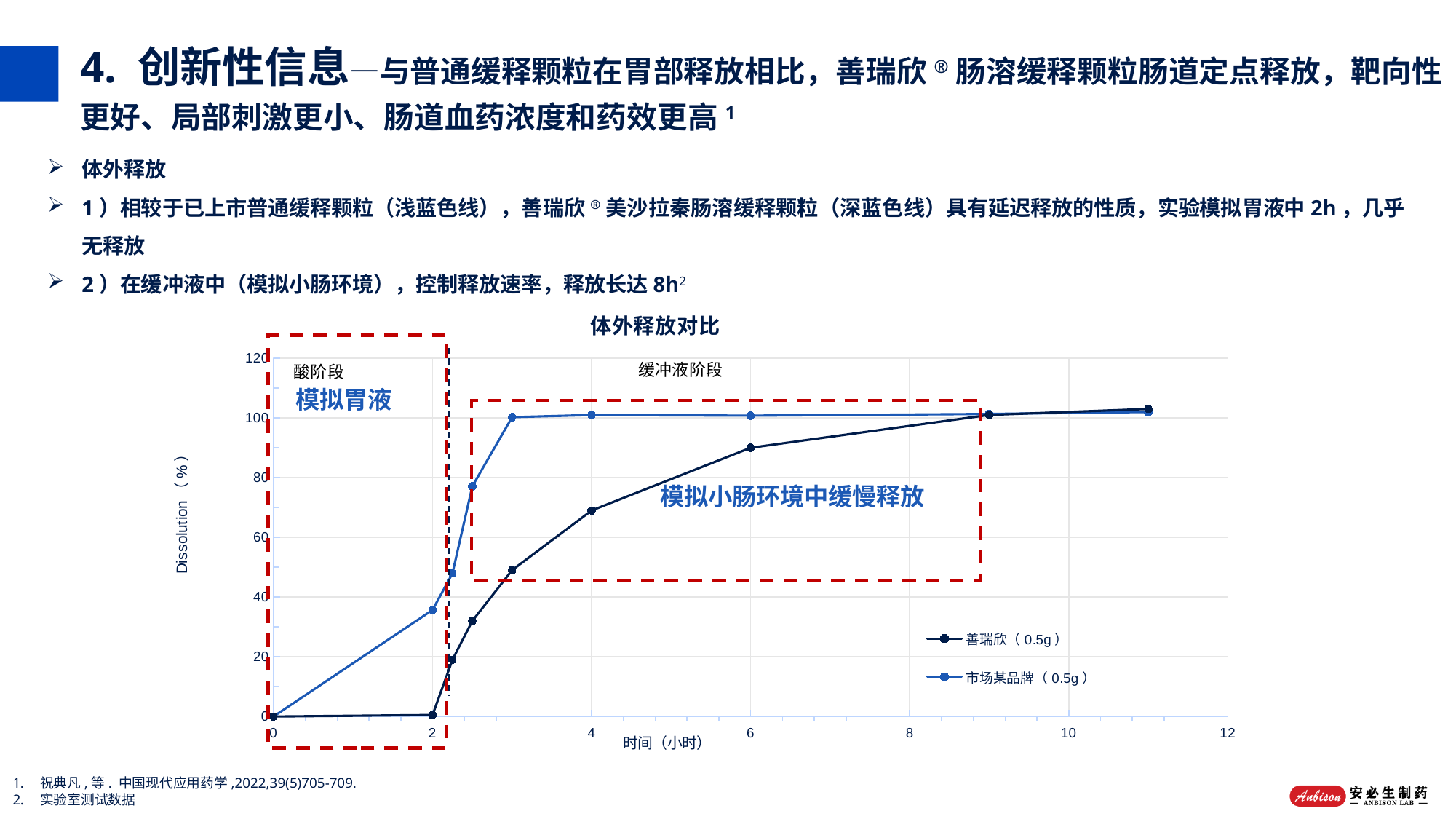
Which series is drawn in the darker blue line? 善瑞欣（0.5g） Is the value for 市场某品牌（0.5g） at 2 hours greater or less than 40? less What kind of chart is shown on the slide? line chart Does the dissolution value for 善瑞欣（0.5g） rise or fall as time increases from 2 to 9 hours? rise At 4 hours, which series has the higher dissolution value, 善瑞欣（0.5g） or 市场某品牌（0.5g）? 市场某品牌（0.5g） What is the dissolution value for 善瑞欣（0.5g） at 0 hours? 0 What is the title of the chart? 体外释放对比 Is the value for 市场某品牌（0.5g） at 3 hours greater or less than 80? greater Is the value for 善瑞欣（0.5g） at 6 hours greater or less than 80? greater How many series does the chart legend list? 2